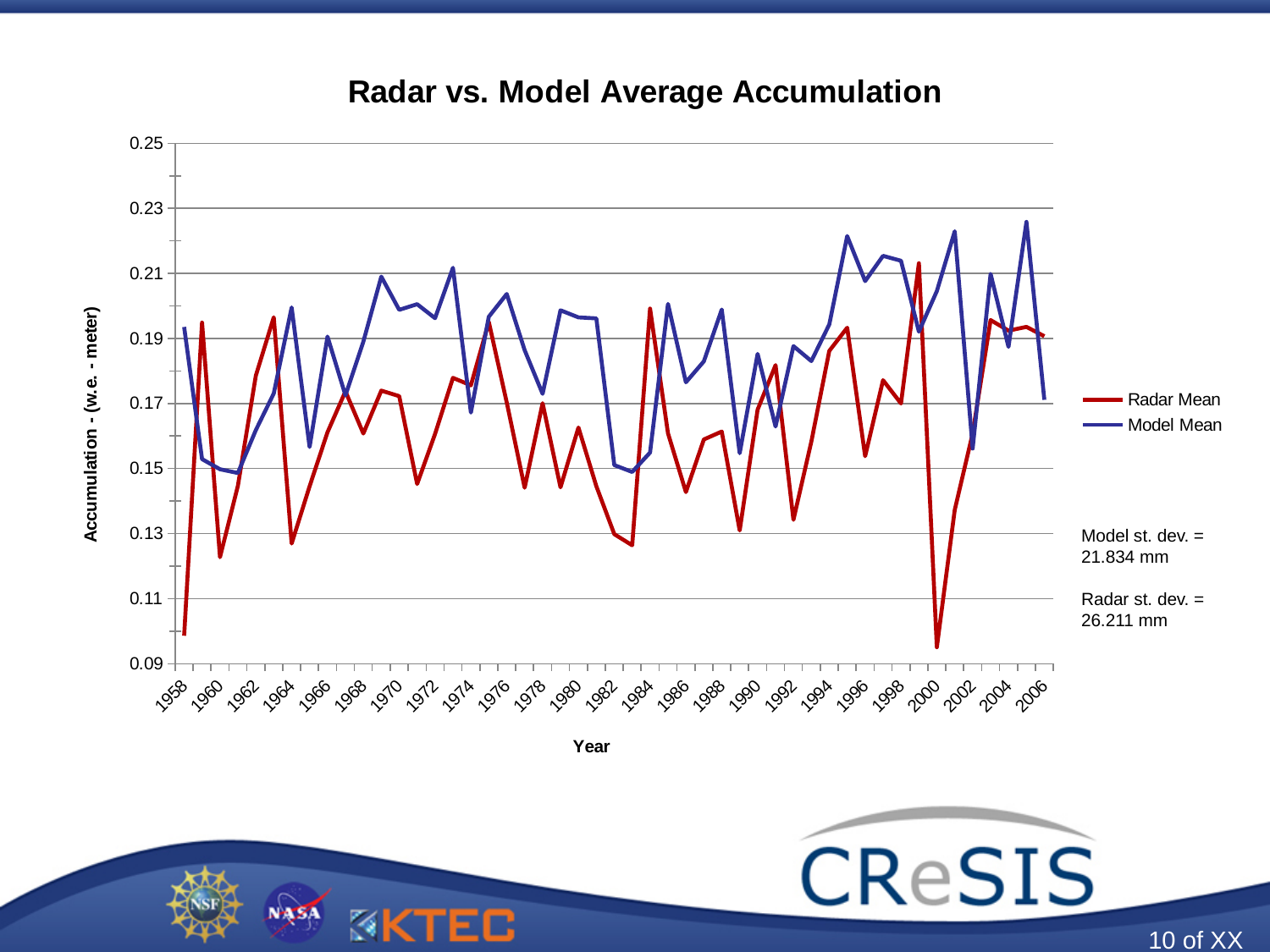
In which year does the Radar Mean reach its highest value? 1999 In which year does the Radar Mean reach its lowest value? 2000 What kind of chart is shown on the slide? Line chart What is the Radar standard deviation printed on the slide? 26.211 mm Is the Model Mean value for 1982 greater or less than 0.17? less What is the Model standard deviation printed on the slide? 21.834 mm Is the Radar Mean value for 1958 greater or less than 0.11? less How many series does the legend list? 2 In 1984, which series has the larger value, Radar Mean or Model Mean? Radar Mean Is the Model Mean value for 1995 greater or less than 0.21? greater Which colour is used for the Model Mean line? Blue What is the title of the chart? Radar vs. Model Average Accumulation